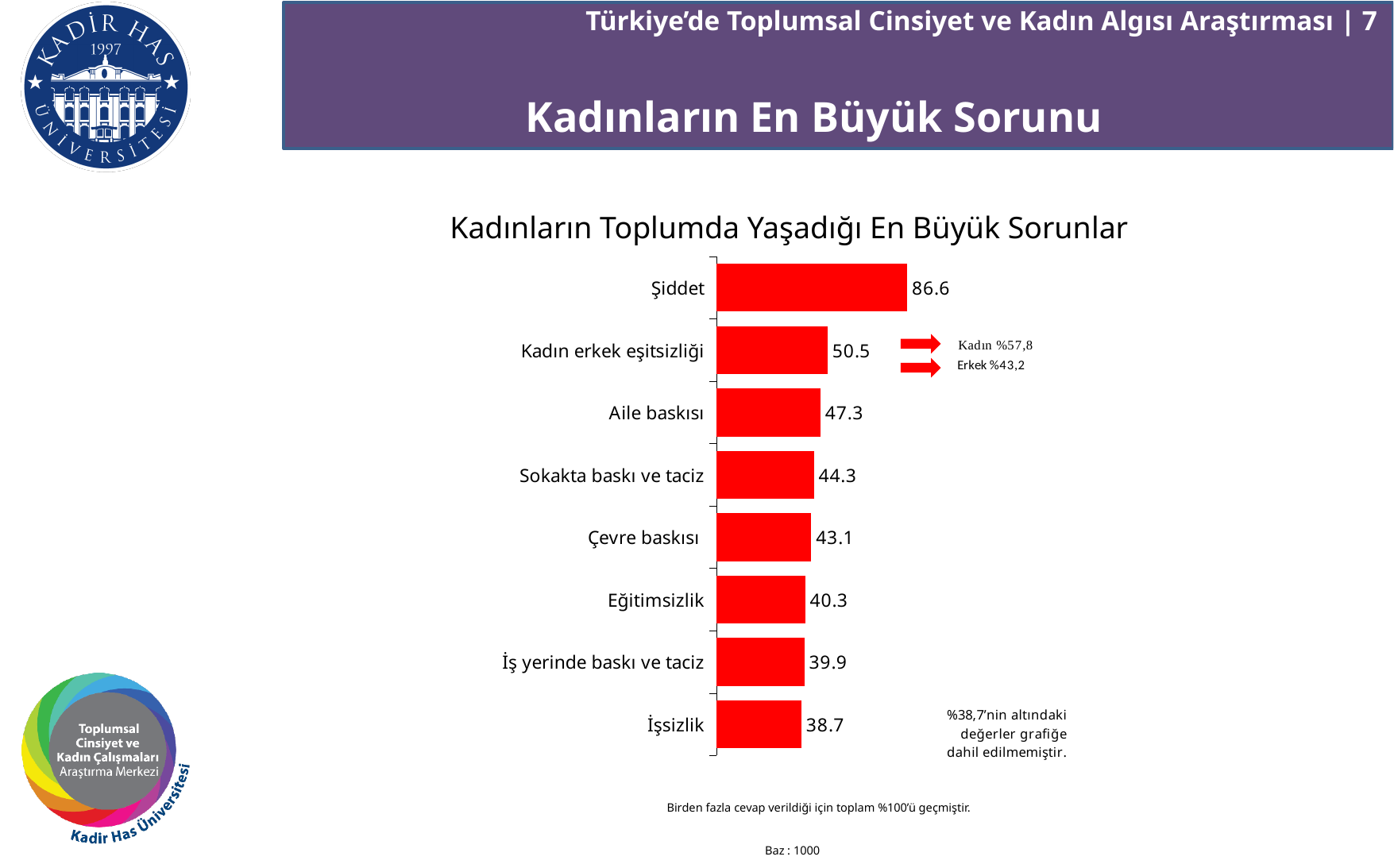
Which category has the highest value? Şiddet What is the value for Aile baskısı? 47.3 How many categories are shown in the chart? 8 What colour are the bars in the chart? red What kind of chart is this? bar chart What is the title of the chart? Kadınların Toplumda Yaşadığı En Büyük Sorunlar Which category has the lowest value? İşsizlik What is the value for İş yerinde baskı ve taciz? 39.9 What is the difference between the values for Sokakta baskı ve taciz and Eğitimsizlik? 4.0 What is the value for Şiddet? 86.6 Which is larger, the value for Çevre baskısı or the value for Eğitimsizlik? Çevre baskısı What is the difference between the values for Şiddet and Kadın erkek eşitsizliği? 36.1